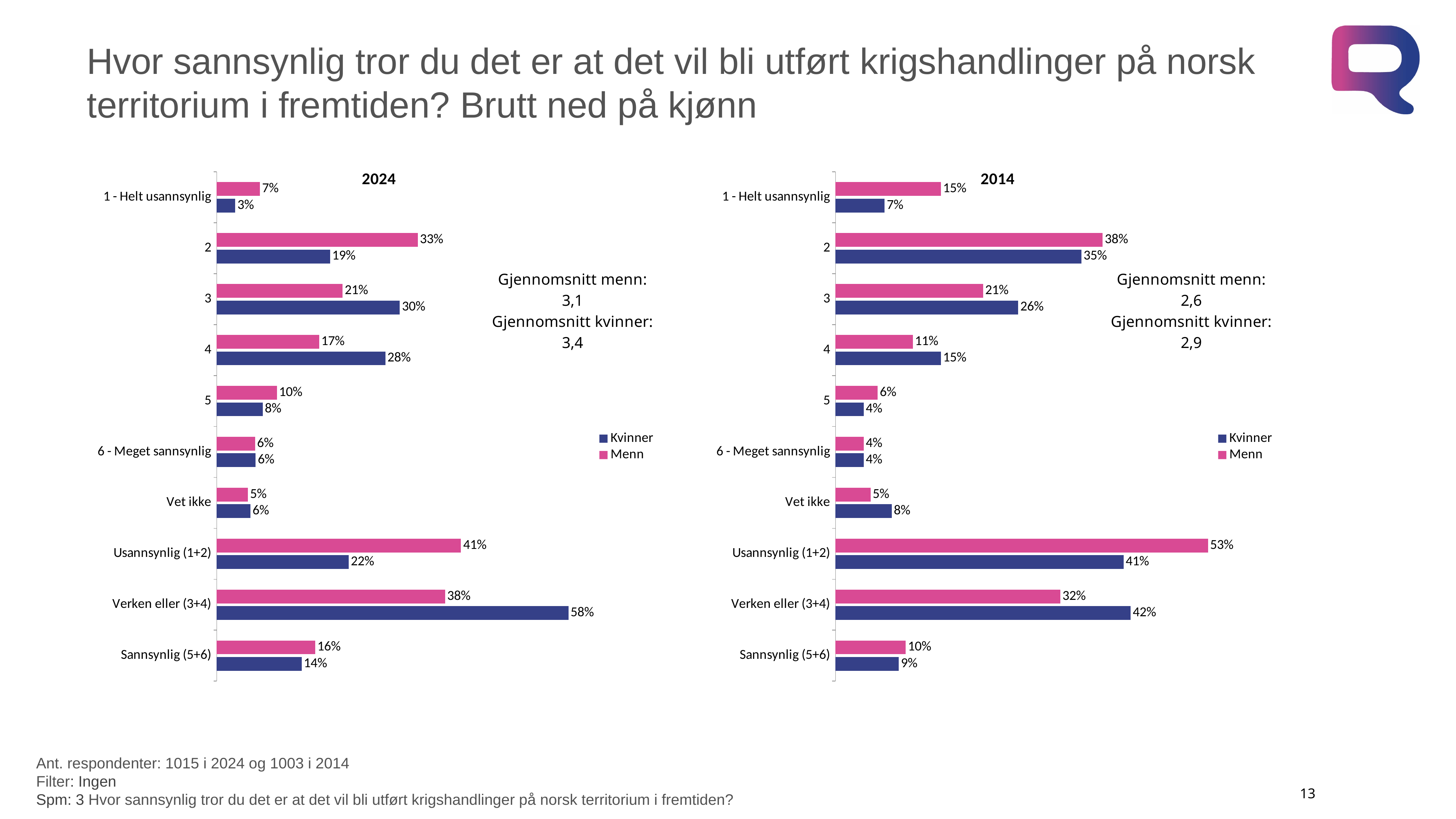
In the 2024 chart, what is the value for Menn in the category "2"? 33% In the 2024 chart, what is the stated average (Gjennomsnitt) for kvinner? 3,4 In the 2014 chart, which is larger for "1 - Helt usannsynlig": Kvinner or Menn? Menn In the 2014 chart, what is the value for Kvinner in the category "Verken eller (3+4)"? 42% In the 2014 chart, which category has the highest value for Menn? Usannsynlig (1+2) In the 2024 chart, which category has the highest value for Kvinner? Verken eller (3+4) In the 2024 chart, which category has the lowest value for Kvinner? 1 - Helt usannsynlig In the 2024 chart, what is the difference between Kvinner and Menn for "Verken eller (3+4)"? 20% What kind of chart is the 2024 chart? Bar chart How many series does the legend of the 2014 chart list? 2 In the 2014 chart, what is the difference between Menn and Kvinner for "Usannsynlig (1+2)"? 12% How many categories are shown in the 2024 chart? 10